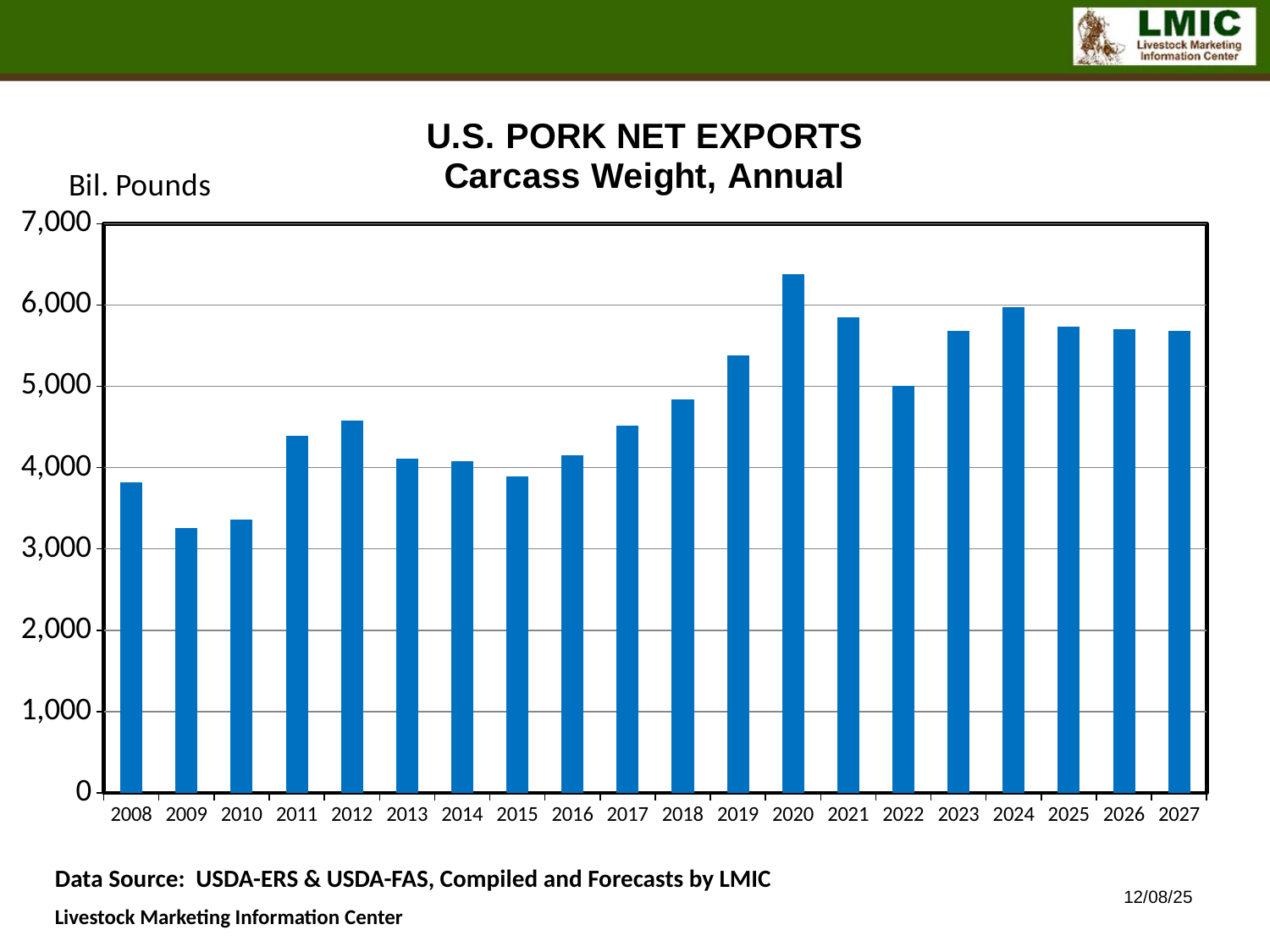
Is the value for 2020 greater or less than 6,000? greater What unit is shown on the y axis label? Bil. Pounds Which is larger, the value for 2012 or the value for 2013? 2012 What type of chart is shown on the slide? bar chart How many years are plotted on the x axis? 20 Do the values generally rise or fall from 2015 to 2020? rise Which year has the lowest U.S. pork net exports? 2009 Is the value for 2015 greater or less than 4,000? less Which year has the highest U.S. pork net exports? 2020 Is the value for 2009 greater or less than 3,000? greater Which is larger, the value for 2021 or the value for 2022? 2021